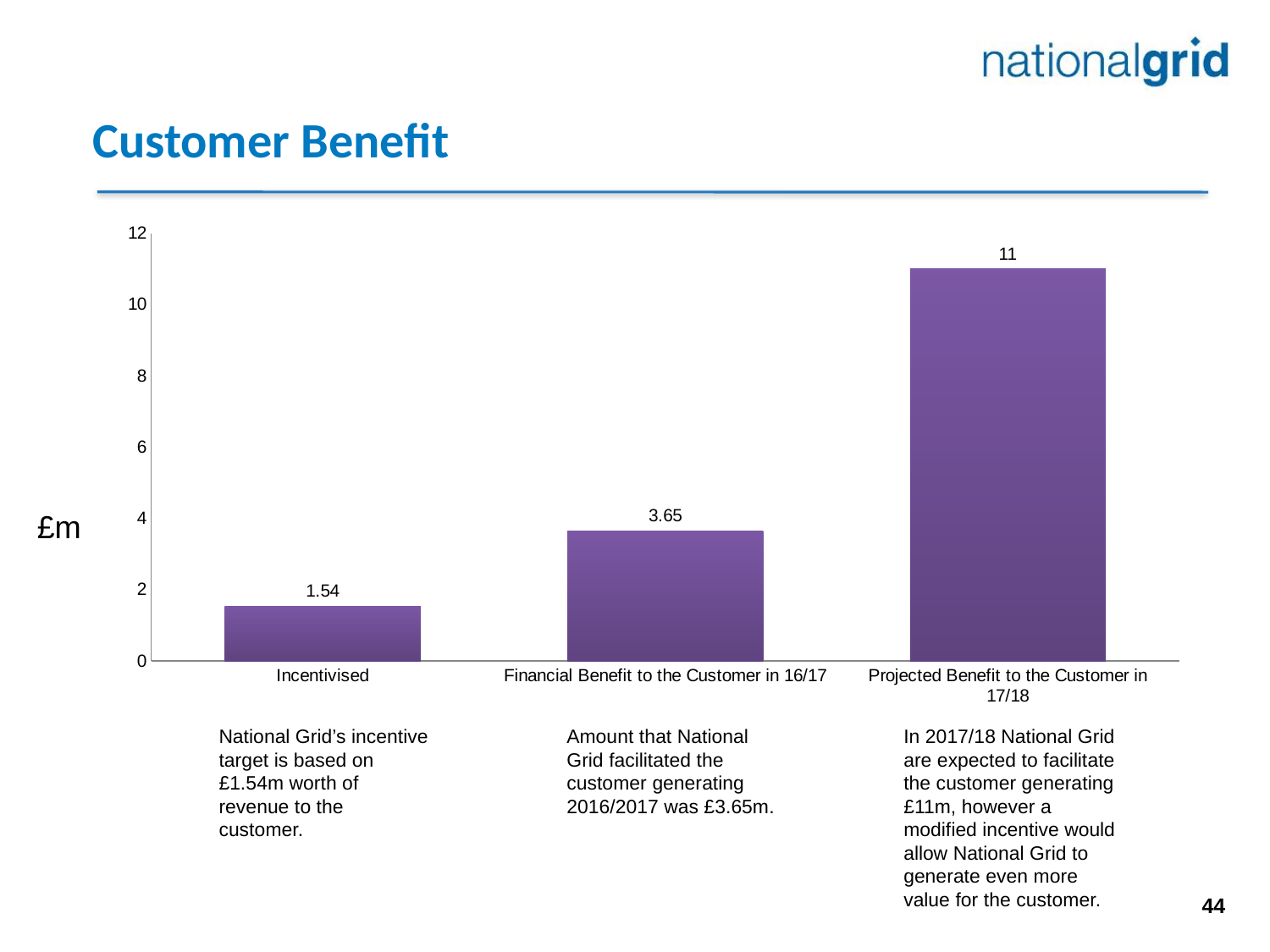
How many categories are shown on the chart? 3 Which category has the lowest value? Incentivised What kind of chart is shown on the slide? Bar chart Is the value for Projected Benefit to the Customer in 17/18 greater or less than 10? greater Which category has the highest value? Projected Benefit to the Customer in 17/18 What is the difference between the Financial Benefit to the Customer in 16/17 and Incentivised? 2.11 What is the difference between the Projected Benefit to the Customer in 17/18 and the Financial Benefit to the Customer in 16/17? 7.35 What is the value for Incentivised? 1.54 What unit label is shown on the vertical axis of the chart? £m What is the value for Financial Benefit to the Customer in 16/17? 3.65 What is the value for Projected Benefit to the Customer in 17/18? 11 Which is larger, the value for Incentivised or the value for Financial Benefit to the Customer in 16/17? Financial Benefit to the Customer in 16/17